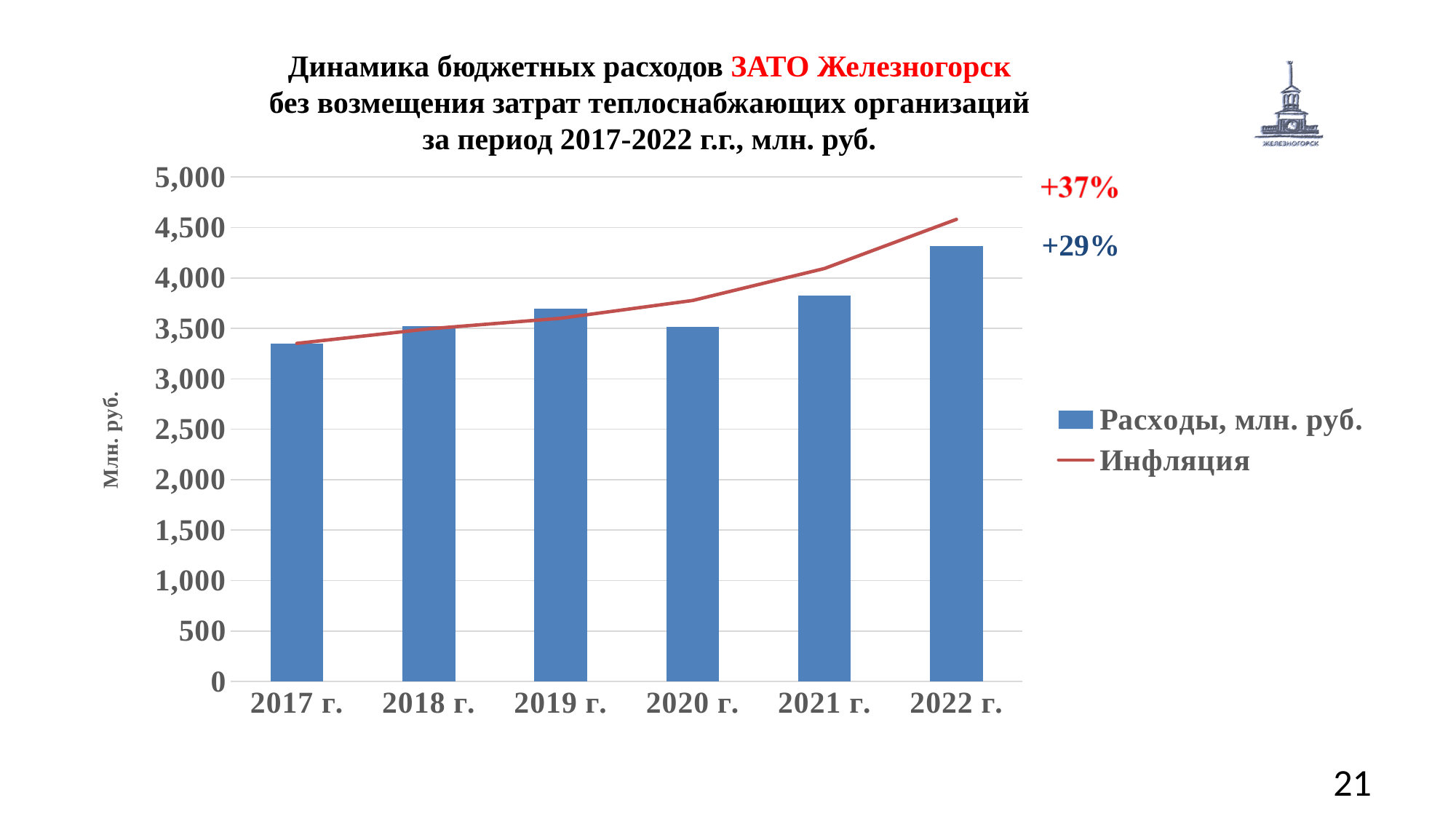
Which is larger, the Расходы bar for 2021 г. or for 2020 г.? 2021 г. How many series does the chart legend list? 2 Is the value of Расходы for 2017 г. greater or less than 3,500? less Which year has the highest bar for Расходы, млн. руб.? 2022 г. Is the Инфляция line value for 2022 г. greater or less than 4,500? greater How many years are shown on the x axis of the chart? 6 Does the Инфляция line rise or fall from 2017 г. to 2022 г.? Rises What kind of chart is shown on the slide? A bar chart with a line overlay Is the value of Расходы for 2022 г. greater or less than 4,000? greater What percentage annotation is shown in red next to the Инфляция line? +37% Which year has the lowest bar for Расходы, млн. руб.? 2017 г.